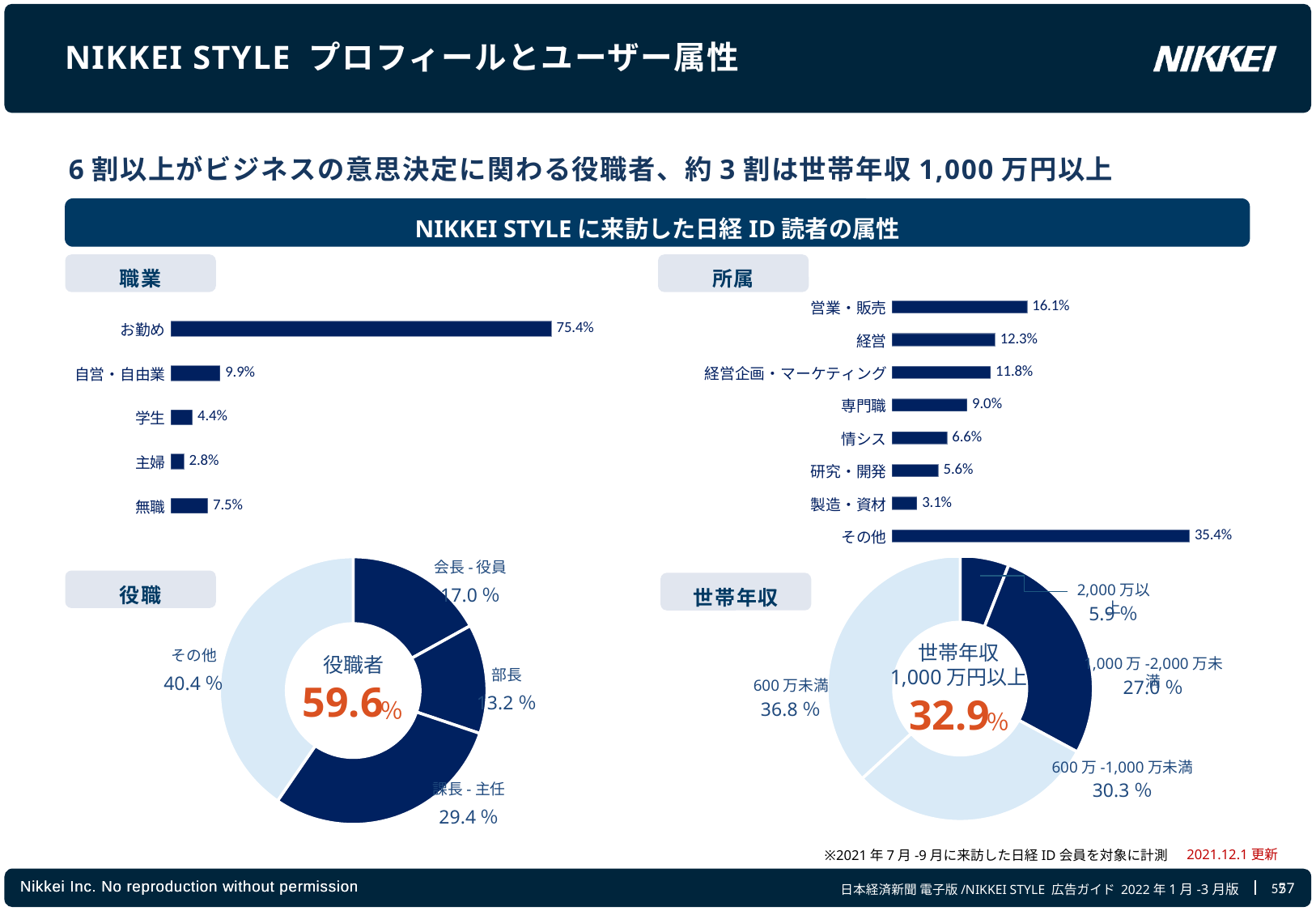
In the 役職 chart, what share does 課長 - 主任 have? 29.4 % What kind of chart is the 役職 chart? Donut chart What percentage is shown in the centre of the 世帯年収 chart for 世帯年収 1,000 万円以上? 32.9% How many categories does the 職業 chart show? 5 In the 所属 chart, which category has the highest value? その他 How many categories does the 所属 chart show? 8 In the 職業 chart, which category has the lowest value? 主婦 In the 世帯年収 chart, what share does 600 万未満 have? 36.8 % In the 所属 chart, what is the value for 経営企画・マーケティング? 11.8% In the 所属 chart, which is larger, 専門職 or 情シス? 専門職 In the 職業 chart, what is the value for お勤め? 75.4% In the 職業 chart, what is the difference between 自営・自由業 and 無職? 2.4%